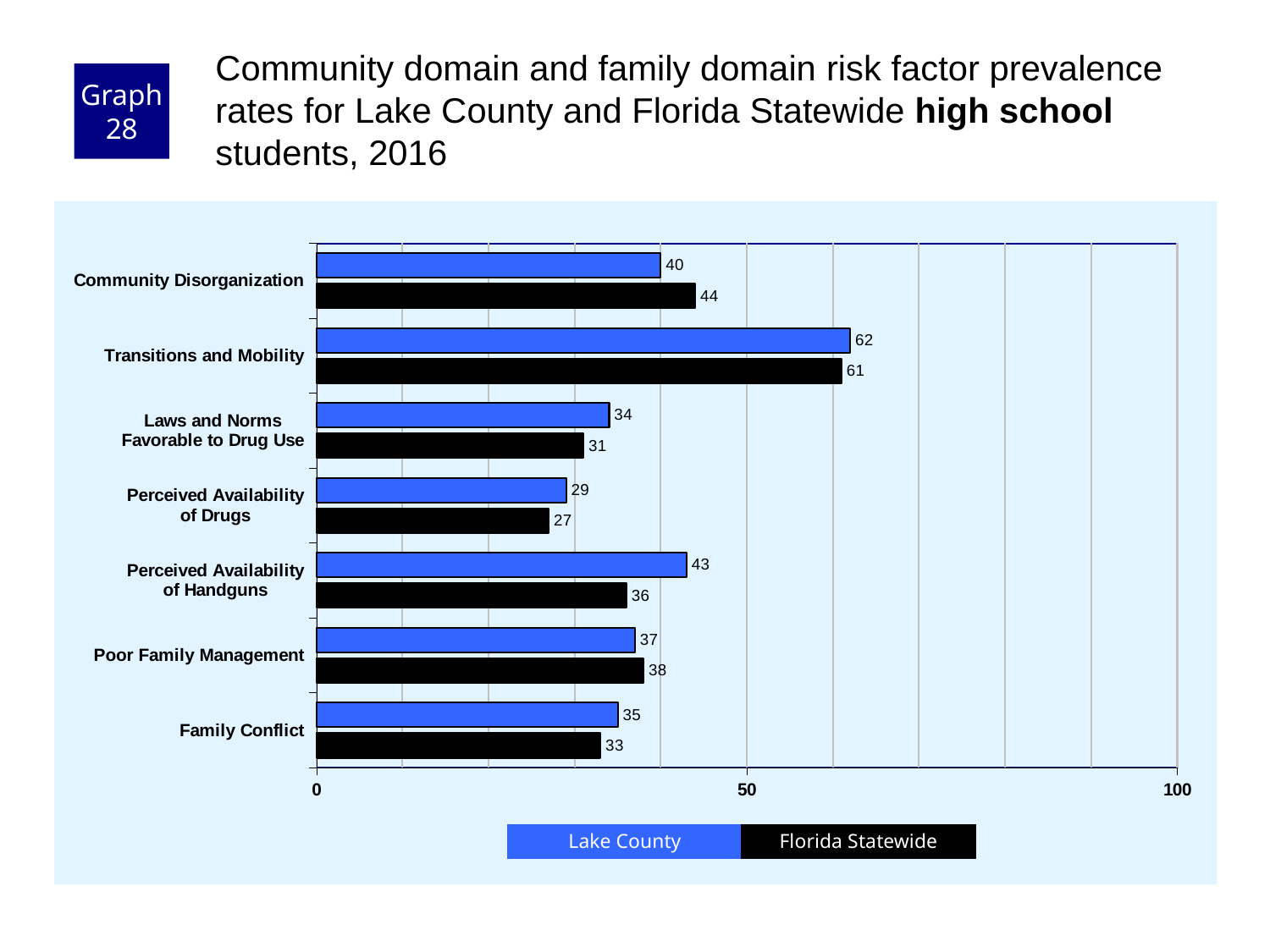
How many risk factors are shown on the chart? 7 Which risk factor has the highest Florida Statewide value? Transitions and Mobility Which colour represents Florida Statewide in the legend? Black What is the Lake County value for Transitions and Mobility? 62 What is the Lake County value for Family Conflict? 35 What is the difference between the Lake County and Florida Statewide values for Perceived Availability of Handguns? 7 What is the Florida Statewide value for Perceived Availability of Handguns? 36 Is the Lake County value for Transitions and Mobility greater or less than 50? greater Which is larger for Community Disorganization: the Lake County value or the Florida Statewide value? Florida Statewide How many series does the legend list? 2 Which risk factor has the lowest Lake County value? Perceived Availability of Drugs What kind of chart is shown on the slide? Bar chart